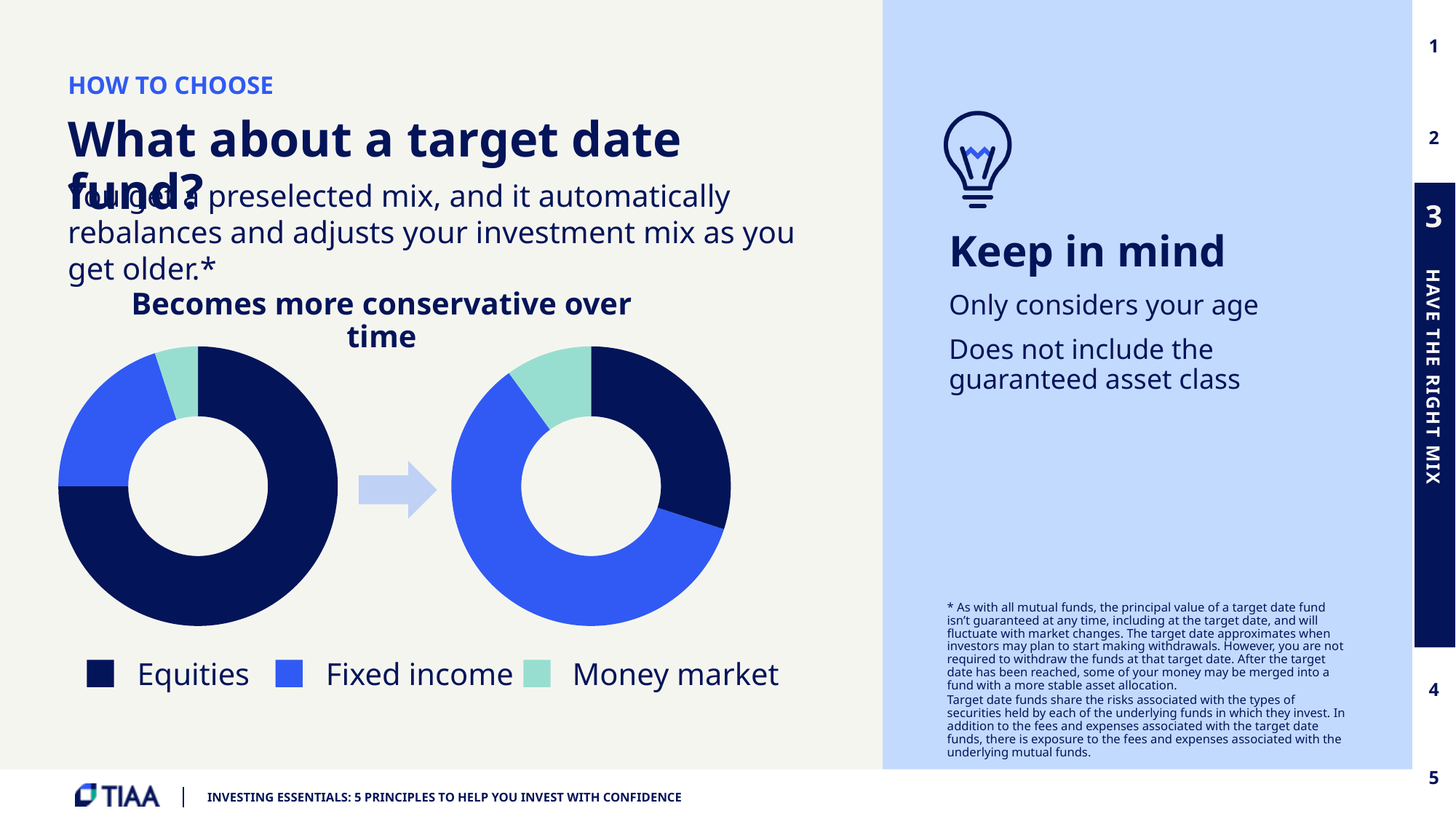
In the right donut chart, which category has the largest share? Fixed income In the right donut chart, which category has the smallest share? Money market Which category is shown in the light teal colour in the legend? Money market What is the title above the donut charts? Becomes more conservative over time In the left donut chart, which category has the largest share? Equities How many donut charts are on the slide? 2 In the left donut chart, which is larger: Equities or Fixed income? Equities In the right donut chart, which is larger: Fixed income or Equities? Fixed income Comparing the two donut charts, does the Equities share increase or decrease from the left chart to the right chart? Decrease In the left donut chart, which category has the smallest share? Money market What kind of charts are shown on the slide? Donut (pie) charts How many categories does the legend list for the donut charts? 3